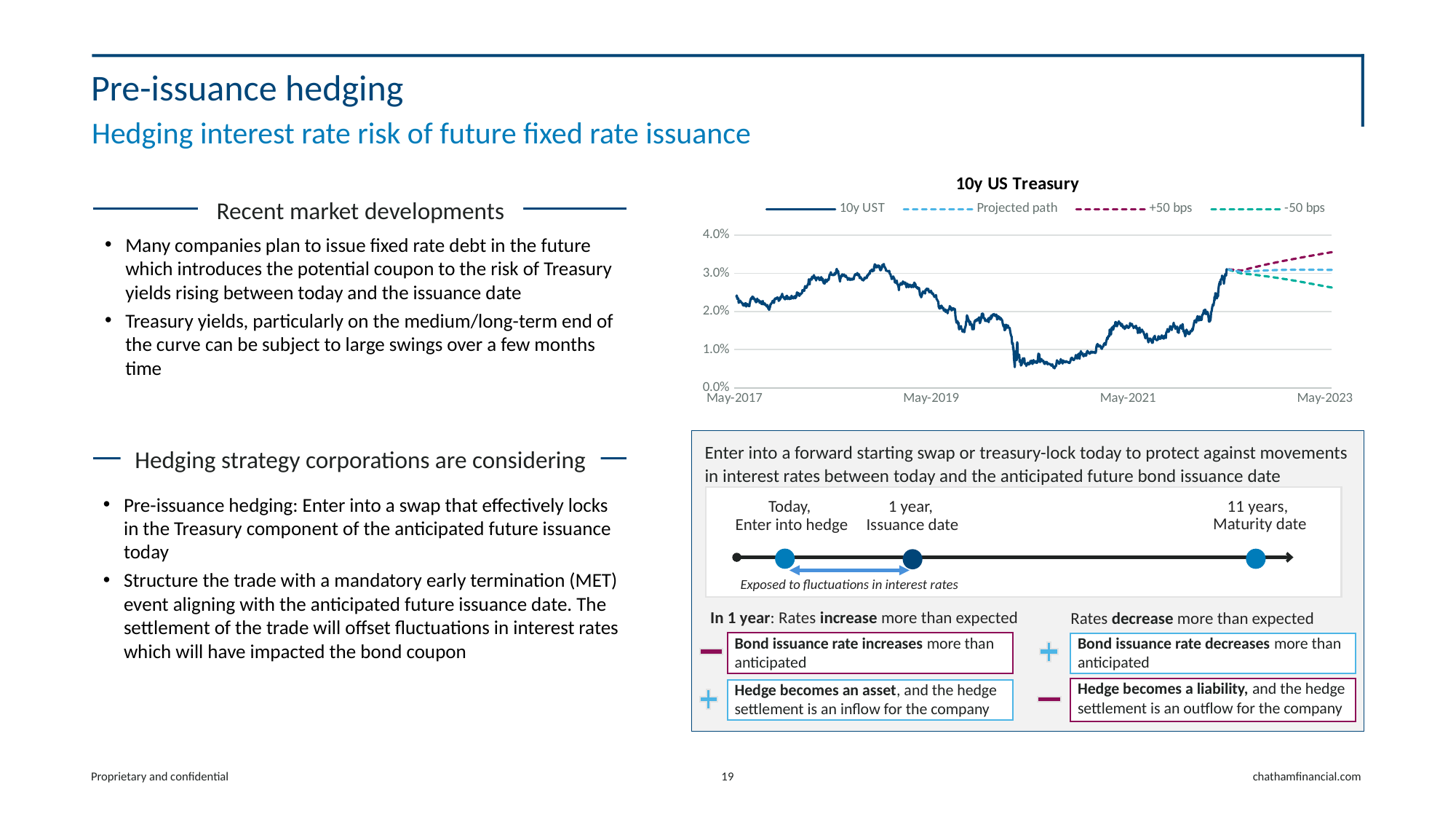
In the "10y US Treasury" chart, is the +50 bps line at May-2023 greater or less than 3.0%? greater In the "10y US Treasury" chart, is the 10y UST value at May-2021 greater or less than 2.0%? less In the "10y US Treasury" chart, which series ends highest at May-2023? +50 bps In the "10y US Treasury" chart, is the lowest point of the 10y UST line greater or less than 1.0%? less What is the title of the chart on the slide? 10y US Treasury Which series in the "10y US Treasury" chart is drawn as a solid line rather than a dashed line? 10y UST How many series does the legend of the "10y US Treasury" chart list? 4 In the "10y US Treasury" chart, which series ends lowest at May-2023? -50 bps What type of chart is the "10y US Treasury" chart? line chart In the "10y US Treasury" chart, does the 10y UST line rise or fall between May-2021 and the end of the solid line? rise